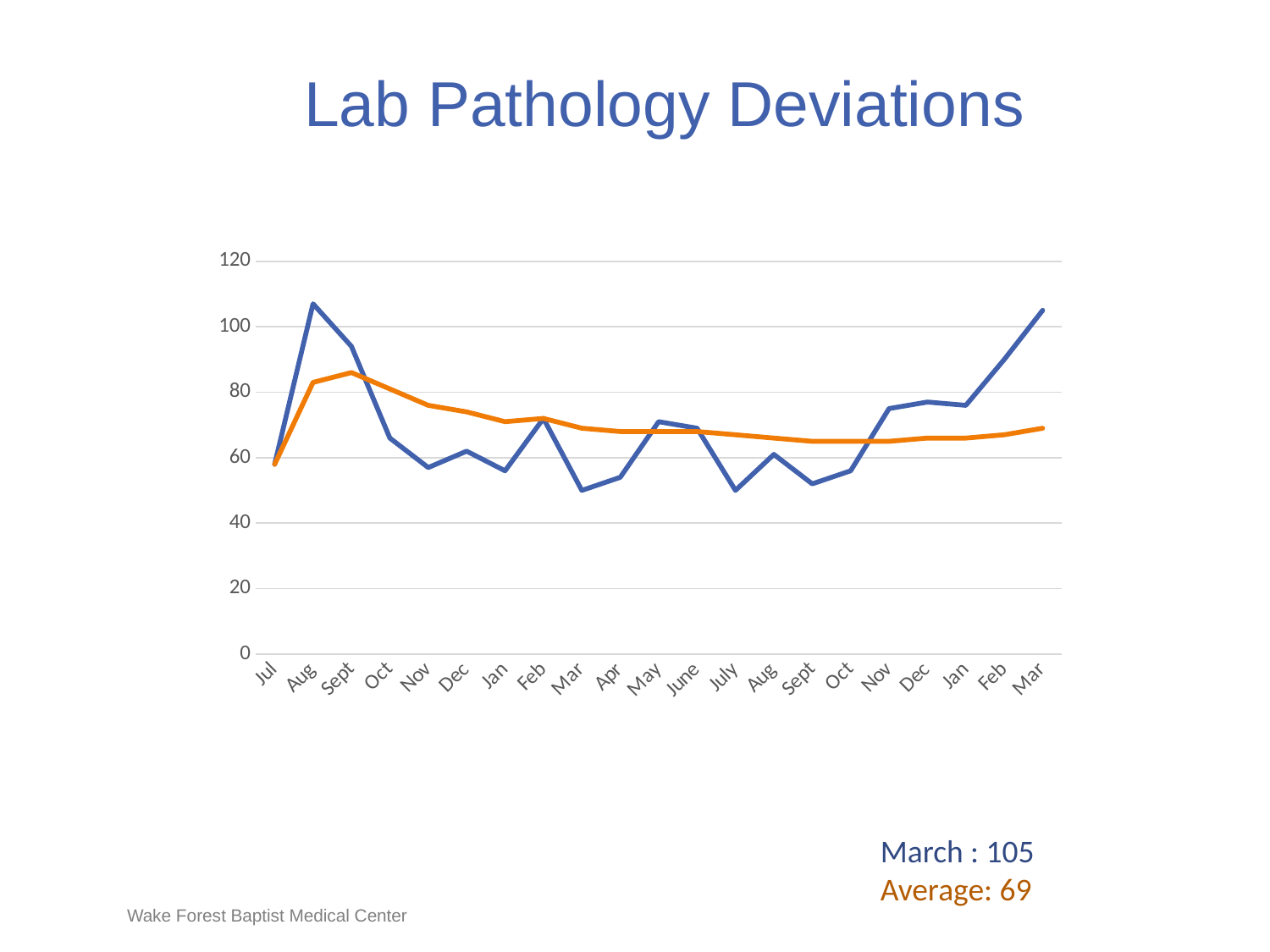
At the first Mar point, which line has the higher value, the blue line or the orange line? orange line What is the value of the blue line at the final Mar point, as printed on the slide? 105 What is the title of the chart? Lab Pathology Deviations At the first Aug point, which line has the higher value, the blue line or the orange line? blue line How many points are plotted along the x axis of the chart? 21 Does the blue line rise or fall from the second Oct point to the final Mar point? rise How many lines are plotted on the chart? 2 What is the Average value printed on the slide? 69 Is the value of the orange line at the first Sept point greater or less than 80? greater What kind of chart is shown on the slide? line chart Is the value of the blue line at the first Aug point greater or less than 100? greater Is the value of the blue line at the first Mar point greater or less than 60? less